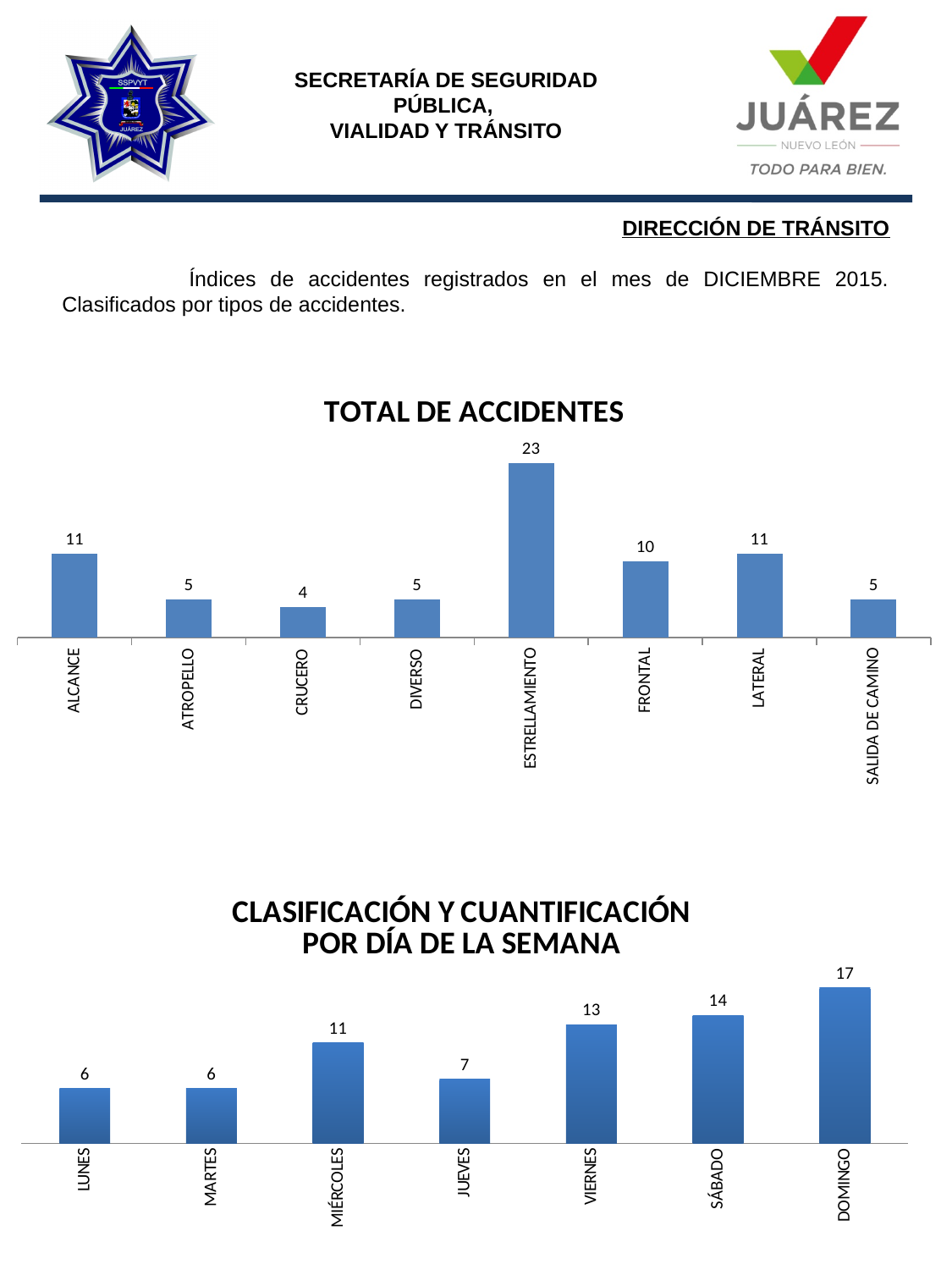
In the 'CLASIFICACIÓN Y CUANTIFICACIÓN POR DÍA DE LA SEMANA' chart, what is the value for DOMINGO? 17 In the 'CLASIFICACIÓN Y CUANTIFICACIÓN POR DÍA DE LA SEMANA' chart, what is the value for MIÉRCOLES? 11 In the 'TOTAL DE ACCIDENTES' chart, what is the value for ESTRELLAMIENTO? 23 In the 'CLASIFICACIÓN Y CUANTIFICACIÓN POR DÍA DE LA SEMANA' chart, how many days are shown? 7 In the 'TOTAL DE ACCIDENTES' chart, how many categories are shown? 8 In the 'TOTAL DE ACCIDENTES' chart, is the value for ALCANCE larger or smaller than the value for FRONTAL? larger In the 'CLASIFICACIÓN Y CUANTIFICACIÓN POR DÍA DE LA SEMANA' chart, what is the difference between SÁBADO and JUEVES? 7 In the 'CLASIFICACIÓN Y CUANTIFICACIÓN POR DÍA DE LA SEMANA' chart, which day has the highest value? DOMINGO What kind of chart is the 'TOTAL DE ACCIDENTES' chart? bar chart In the 'TOTAL DE ACCIDENTES' chart, what is the difference between ESTRELLAMIENTO and FRONTAL? 13 In the 'TOTAL DE ACCIDENTES' chart, which category has the lowest value? CRUCERO In the 'TOTAL DE ACCIDENTES' chart, which category has the highest value? ESTRELLAMIENTO